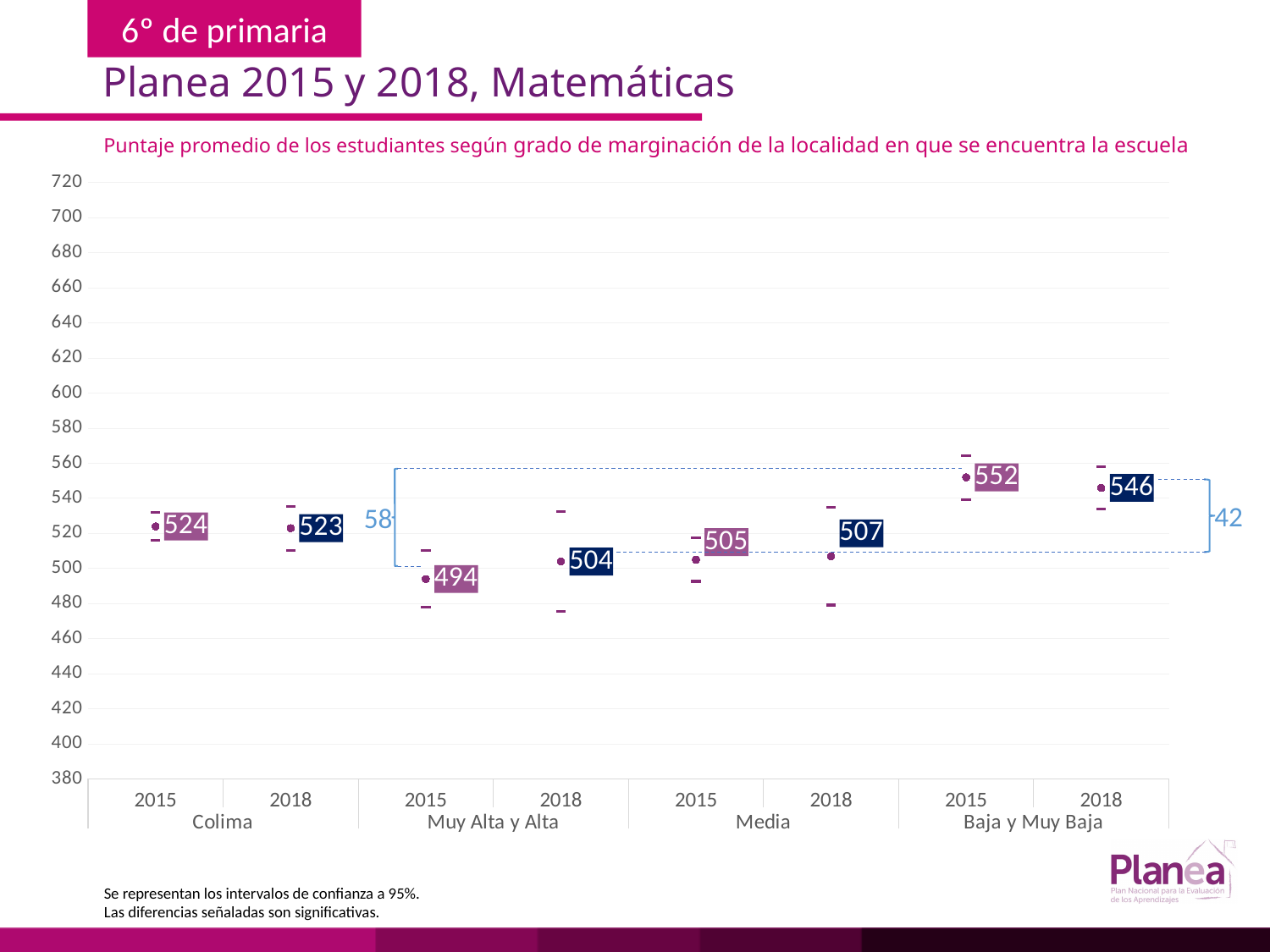
Which group and year has the lowest average score? Muy Alta y Alta, 2015 (494) What is the difference between the 2015 scores of Baja y Muy Baja and Muy Alta y Alta? 58 What is the average score for the Media group in 2015? 505 What is the average score for the Muy Alta y Alta marginalization group in 2018? 504 Which group and year has the highest average score? Baja y Muy Baja, 2015 (552) What is the difference between the 2018 scores of Baja y Muy Baja and Muy Alta y Alta? 42 What kind of chart is shown on the slide? Dot plot with confidence intervals What is the average score for the Baja y Muy Baja group in 2018? 546 Is the 2015 score for Baja y Muy Baja greater or less than 540? greater Which is larger, the Muy Alta y Alta score in 2015 or in 2018? 2018 (504) What is the average score for Colima in 2015? 524 How many data points (group-year combinations) are plotted on the chart? 8